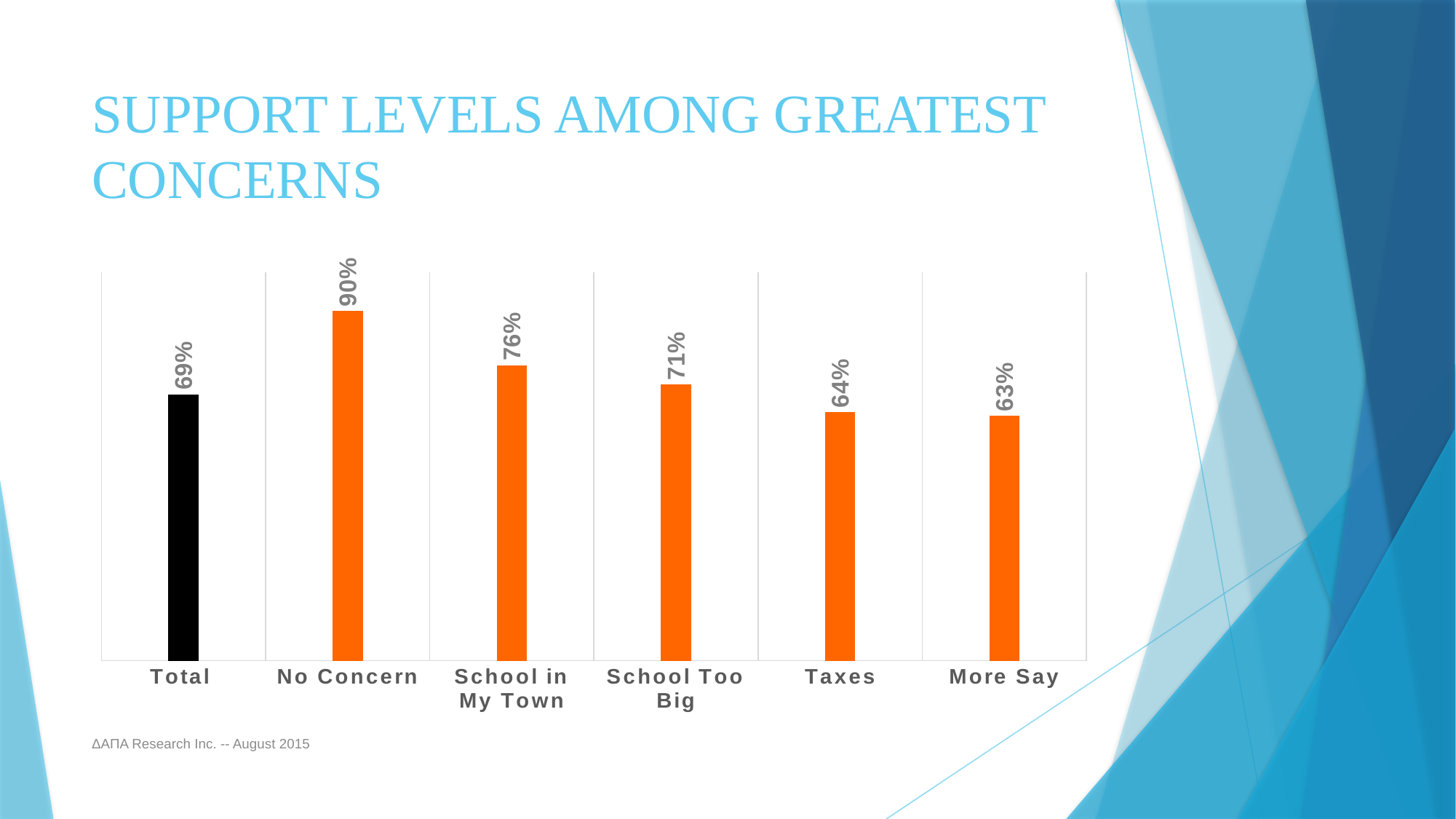
How many categories are shown on the x axis? 6 Which bar is coloured black rather than orange? Total What kind of chart is shown on the slide? Bar chart Which category has the lowest support level? More Say What is the value of the Total bar? 69% What is the support level for School in My Town? 76% Which is larger, the support level for Total or for School Too Big? School Too Big What is the support level for Taxes? 64% What is the support level for No Concern? 90% What is the difference between the support levels for No Concern and School Too Big? 19% What is the difference between the support levels for School in My Town and Taxes? 12% Which category has the highest support level? No Concern